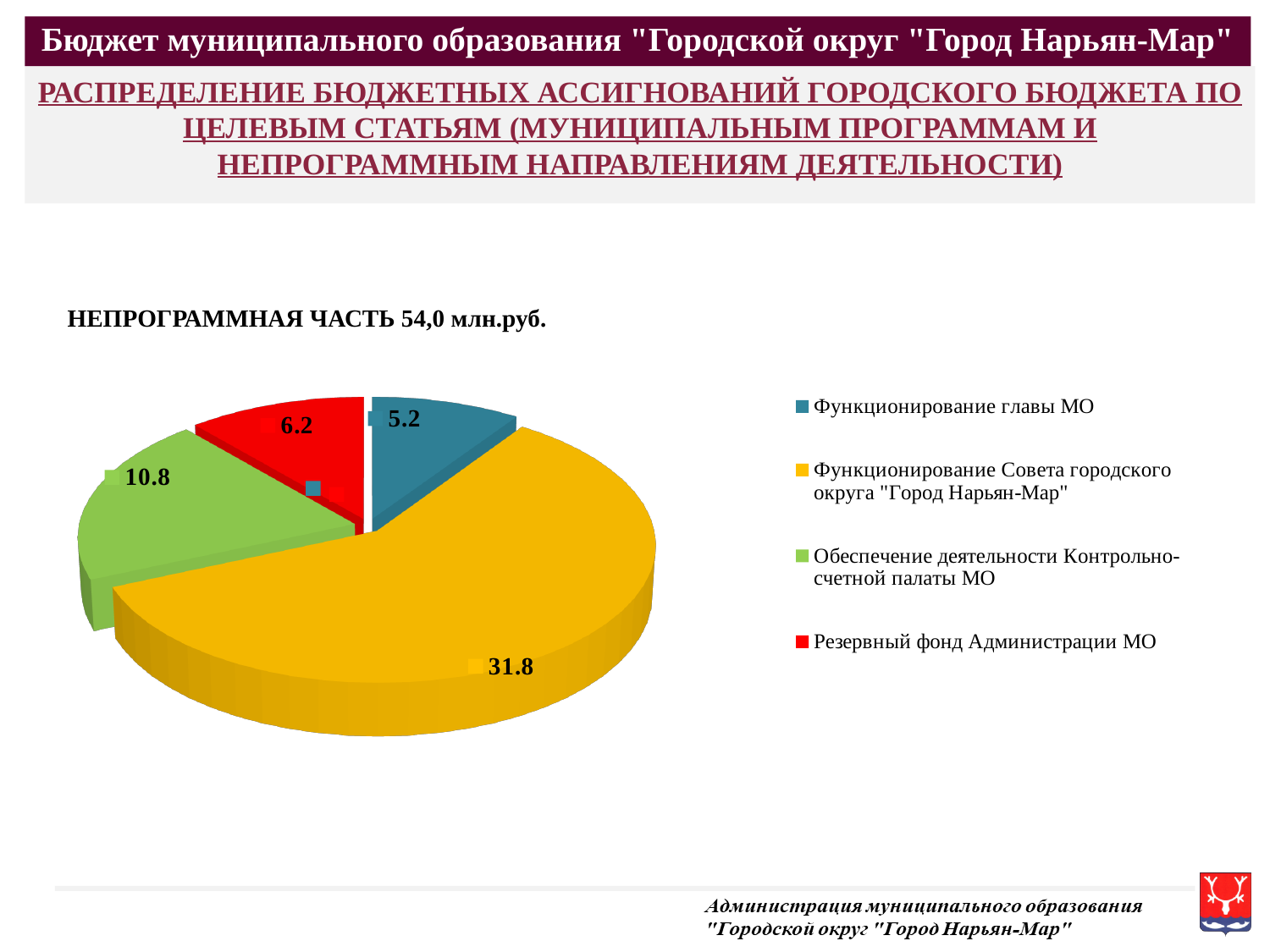
What is the value for "Функционирование Совета городского округа "Город Нарьян-Мар""? 31.8 Which category has the smallest slice of the pie? Функционирование главы МО Which category has the largest slice of the pie? Функционирование Совета городского округа "Город Нарьян-Мар" What type of chart is shown on the slide? Pie chart Which is larger: "Обеспечение деятельности Контрольно-счетной палаты МО" or "Резервный фонд Администрации МО"? Обеспечение деятельности Контрольно-счетной палаты МО What is the difference between the values for "Функционирование Совета городского округа "Город Нарьян-Мар"" and "Функционирование главы МО"? 26.6 What is the difference between the values for "Обеспечение деятельности Контрольно-счетной палаты МО" and "Резервный фонд Администрации МО"? 4.6 What is the value for "Функционирование главы МО"? 5.2 What colour is the slice for "Резервный фонд Администрации МО"? Red How many categories does the pie chart show? 4 What is the value for "Резервный фонд Администрации МО"? 6.2 What is the value for "Обеспечение деятельности Контрольно-счетной палаты МО"? 10.8